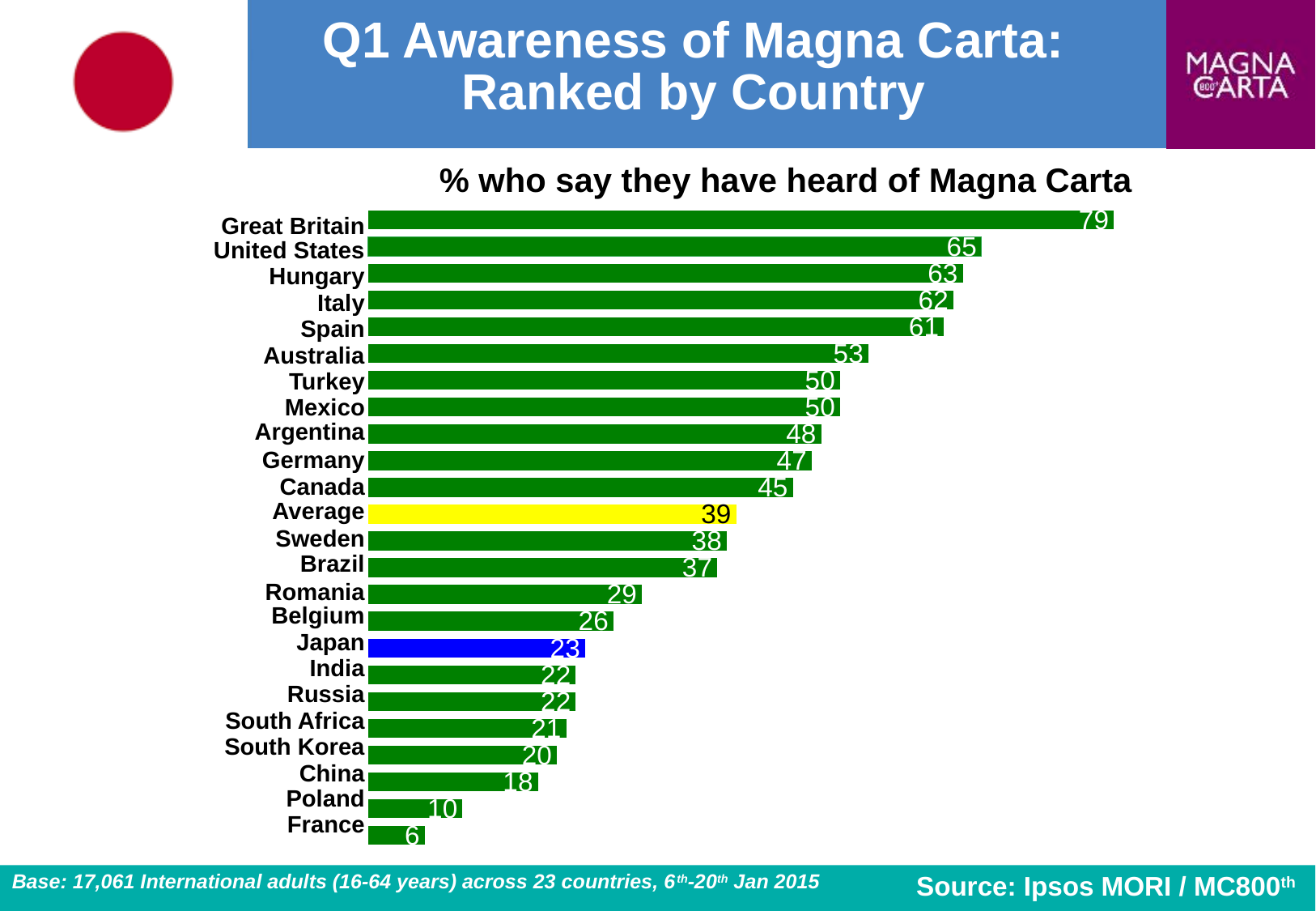
What is the value shown for Japan? 23 What is the difference between the values for Japan and the Average? 16 How many bars are shown on the chart, including the Average bar? 24 Which country has the lowest percentage who say they have heard of Magna Carta? France Which has a higher value, Canada or Germany? Germany Which bar on the chart is coloured blue? Japan What percentage of people in Great Britain say they have heard of Magna Carta? 79 What kind of chart is shown on the slide? Bar chart Which has a higher value, Sweden or Brazil? Sweden Which country has the highest percentage who say they have heard of Magna Carta? Great Britain What is the Average value shown on the chart? 39 What is the difference between the values for Great Britain and the United States? 14